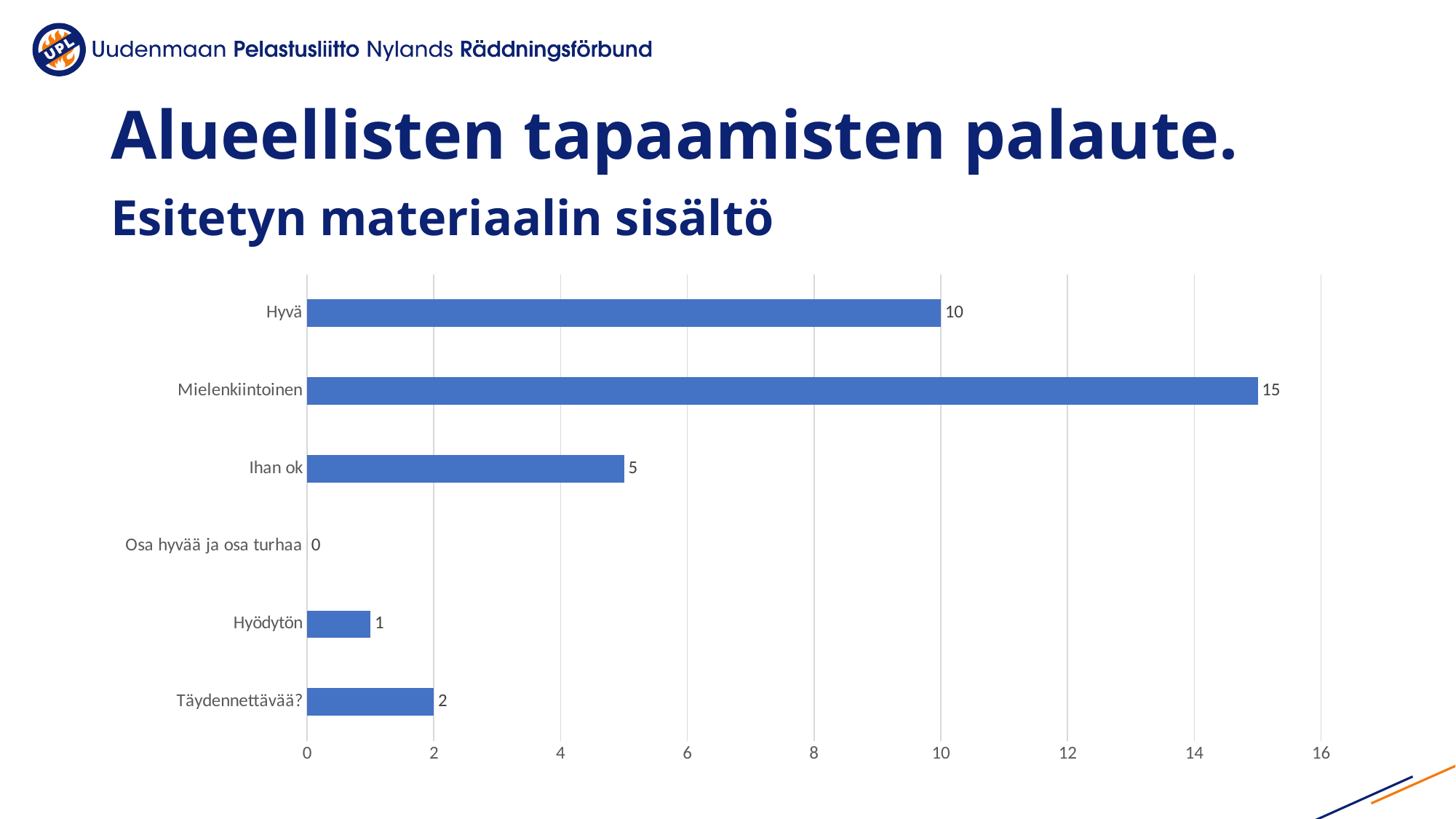
What is the value for Täydennettävää? 2 What is the value for Hyvä? 10 What is the difference between the values for Mielenkiintoinen and Hyvä? 5 What kind of chart is shown on the slide? Bar chart What is the value for Mielenkiintoinen? 15 What is the value for Ihan ok? 5 What is the value for Osa hyvää ja osa turhaa? 0 How many categories are shown in the chart? 6 Which category has the highest value? Mielenkiintoinen Which is larger, the value for Hyödytön or the value for Täydennettävää? Täydennettävää? What is the subtitle above the chart? Esitetyn materiaalin sisältö Which category has the lowest value? Osa hyvää ja osa turhaa